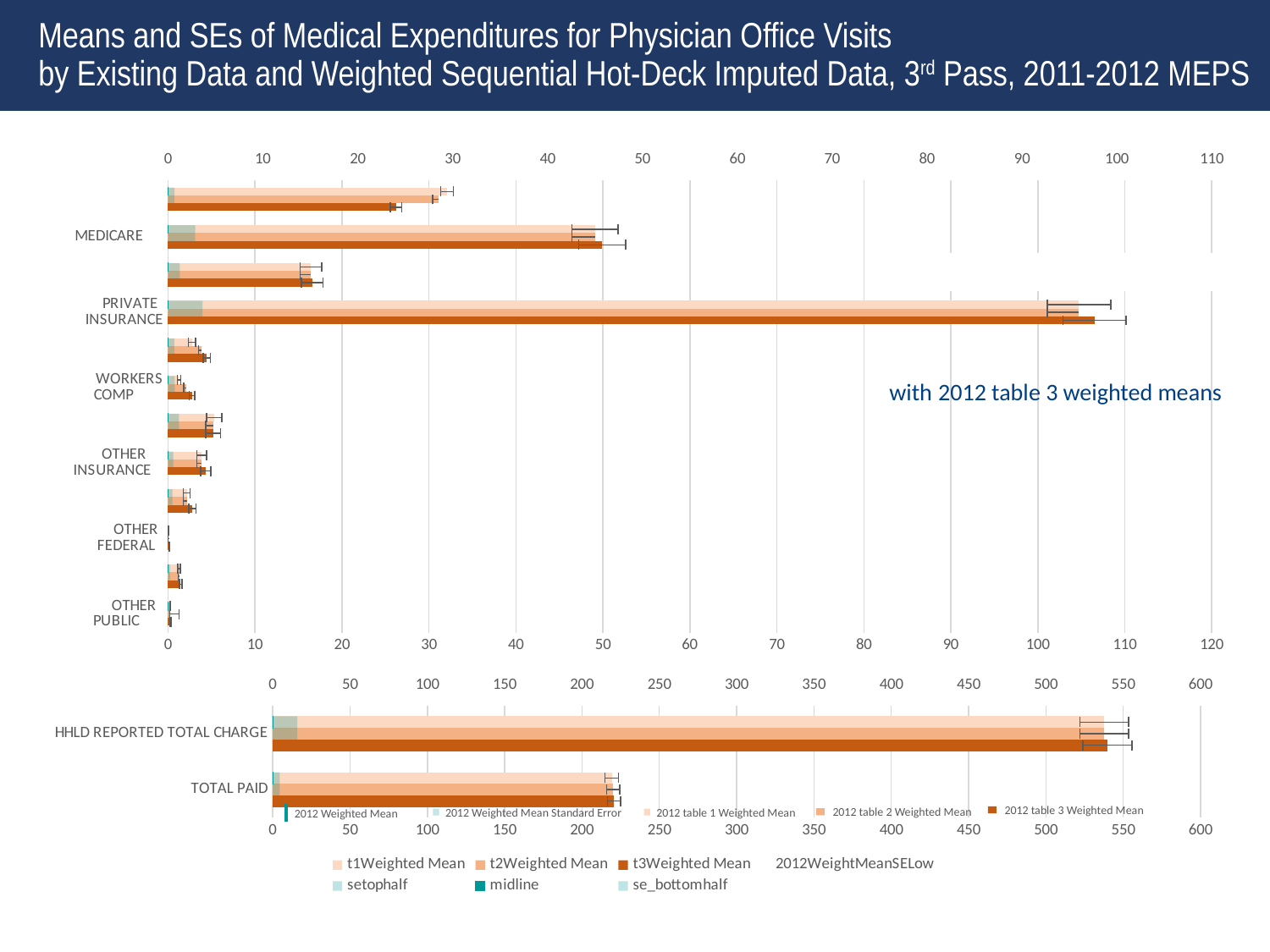
In the bottom chart, which category has the longest bars? HHLD REPORTED TOTAL CHARGE How many categories are shown in the bottom chart? 2 In the bottom chart, which category has the shortest bars? TOTAL PAID What kind of chart is shown on the slide? Bar chart In the bottom chart, is the value for HHLD REPORTED TOTAL CHARGE greater or less than 500? greater In the bottom chart, is the value for TOTAL PAID greater or less than 250? less What annotation text appears in blue inside the top chart? with 2012 table 3 weighted means In the top chart, which category has the longest bar? PRIVATE INSURANCE How many categories are labelled on the vertical axis of the top chart? 6 In the bottom chart, which is larger, HHLD REPORTED TOTAL CHARGE or TOTAL PAID? HHLD REPORTED TOTAL CHARGE In the top chart, which category has the smallest values? OTHER FEDERAL What is the highest tick value on the horizontal axis of the bottom chart? 600